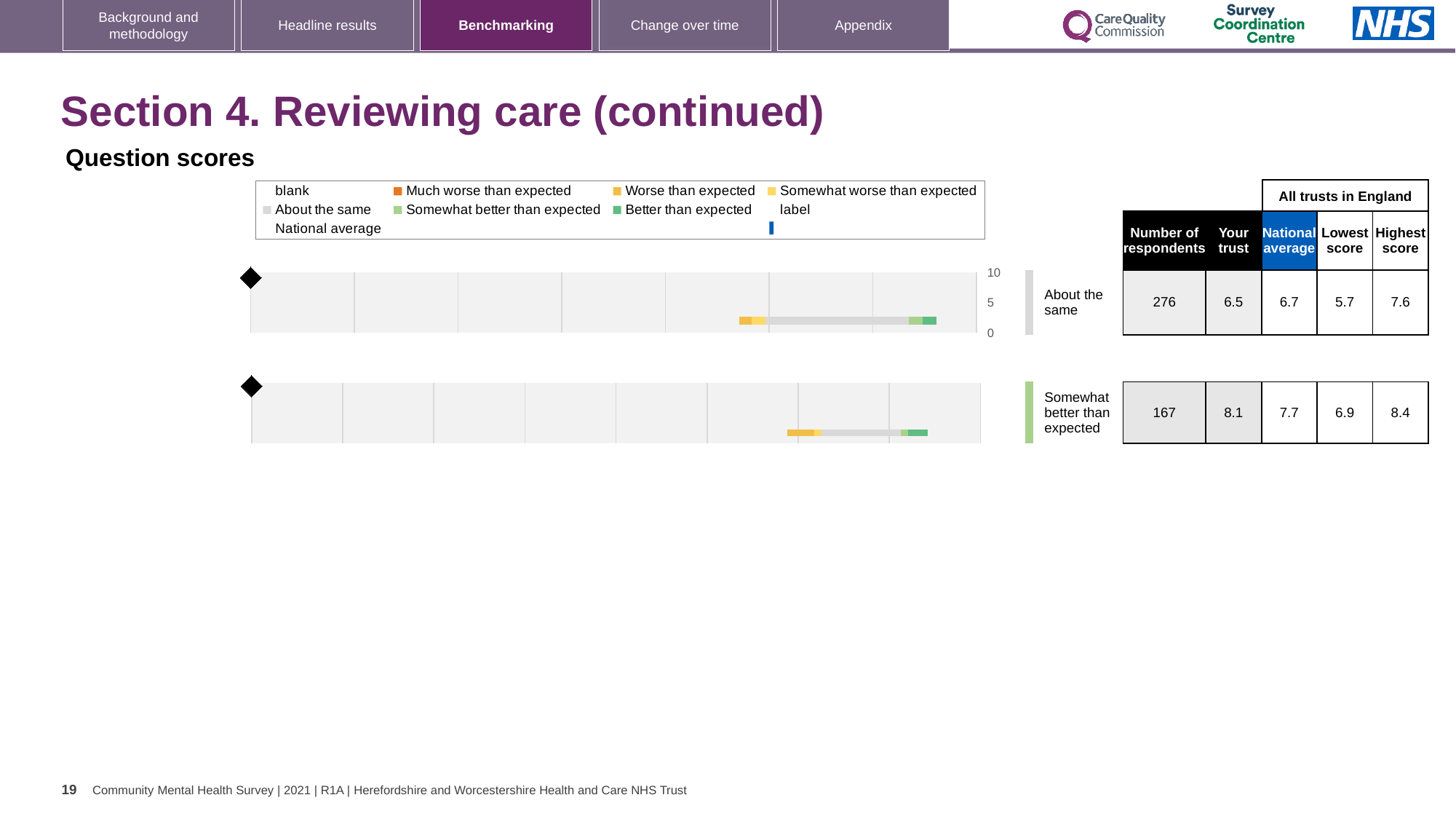
What is the highest value shown on the vertical axis of the top chart? 10 For the bottom chart (rated 'Somewhat better than expected'), what is the number of respondents? 167 For the top chart (rated 'About the same'), what is the difference between the highest score and the lowest score among all trusts in England? 1.9 How many charts are shown on the slide? 2 What kind of chart is the top chart on the slide? bar chart For the top chart (rated 'About the same'), what is the national average in the table? 6.7 For the bottom chart, is the 'Your trust' score greater or less than the national average? greater For the bottom chart (rated 'Somewhat better than expected'), what is the 'Your trust' score in the table? 8.1 What is the benchmark rating label shown next to the bottom chart? Somewhat better than expected For the bottom chart (rated 'Somewhat better than expected'), what is the highest score among all trusts in England? 8.4 For the top chart (rated 'About the same'), what is the 'Your trust' score in the table? 6.5 Which chart has the larger 'Your trust' score, the top chart or the bottom chart? bottom chart